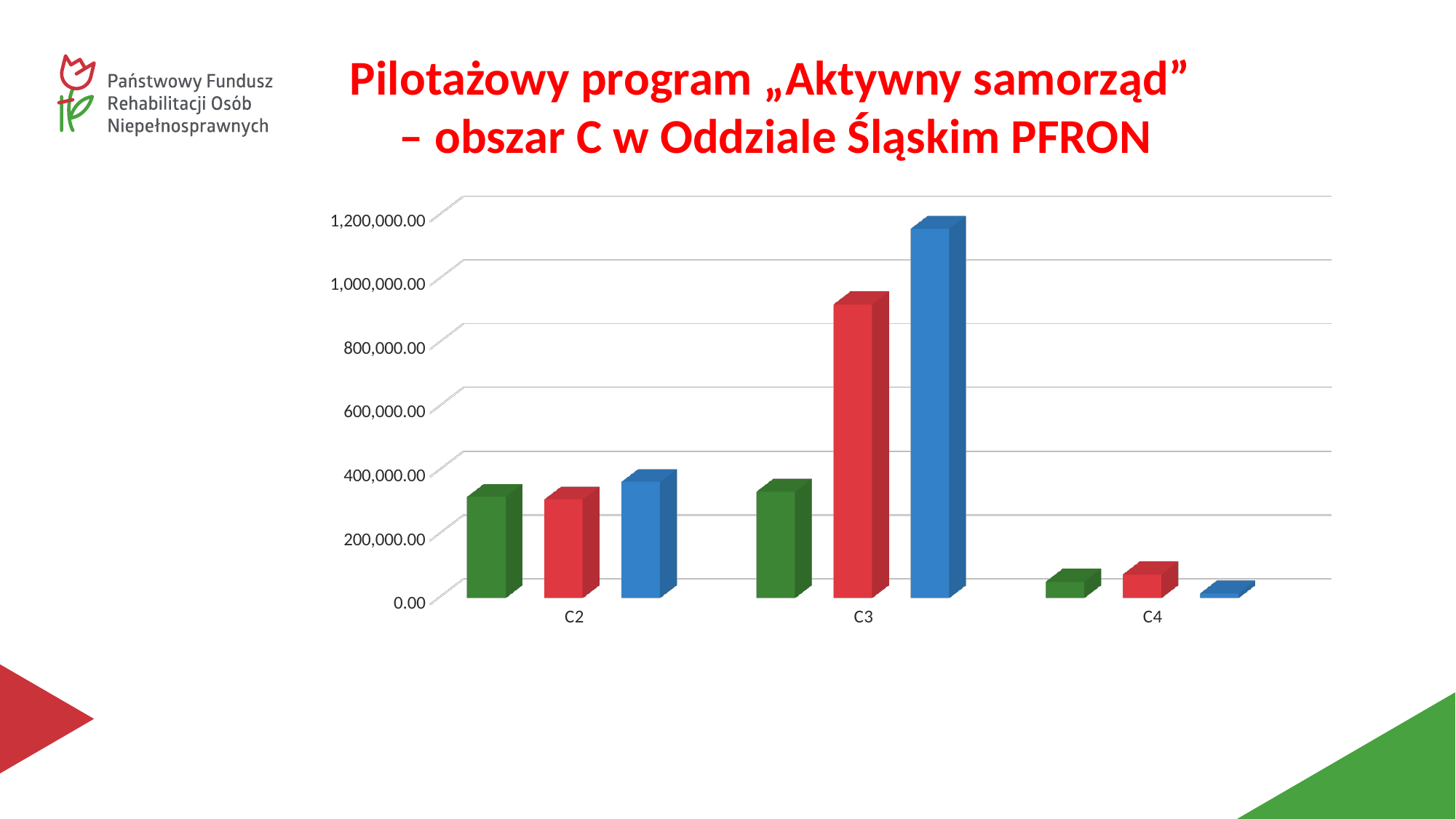
Is the value of the red bar for C3 greater or less than 800,000.00? greater What is the highest value labelled on the vertical axis of the chart? 1,200,000.00 Which is larger: the green bar for C2 or the green bar for C4? the green bar for C2 Which is larger for C3: the blue bar or the red bar? the blue bar How many categories are shown on the x axis of the chart? 3 What kind of chart is shown on the slide? bar chart Which category contains the shortest bar in the chart? C4 Which category contains the tallest bar in the chart? C3 Is the value of the blue bar for C3 greater or less than 1,000,000.00? greater How many bars are plotted for each category in the chart? 3 Is the value of the green bar for C4 greater or less than 200,000.00? less